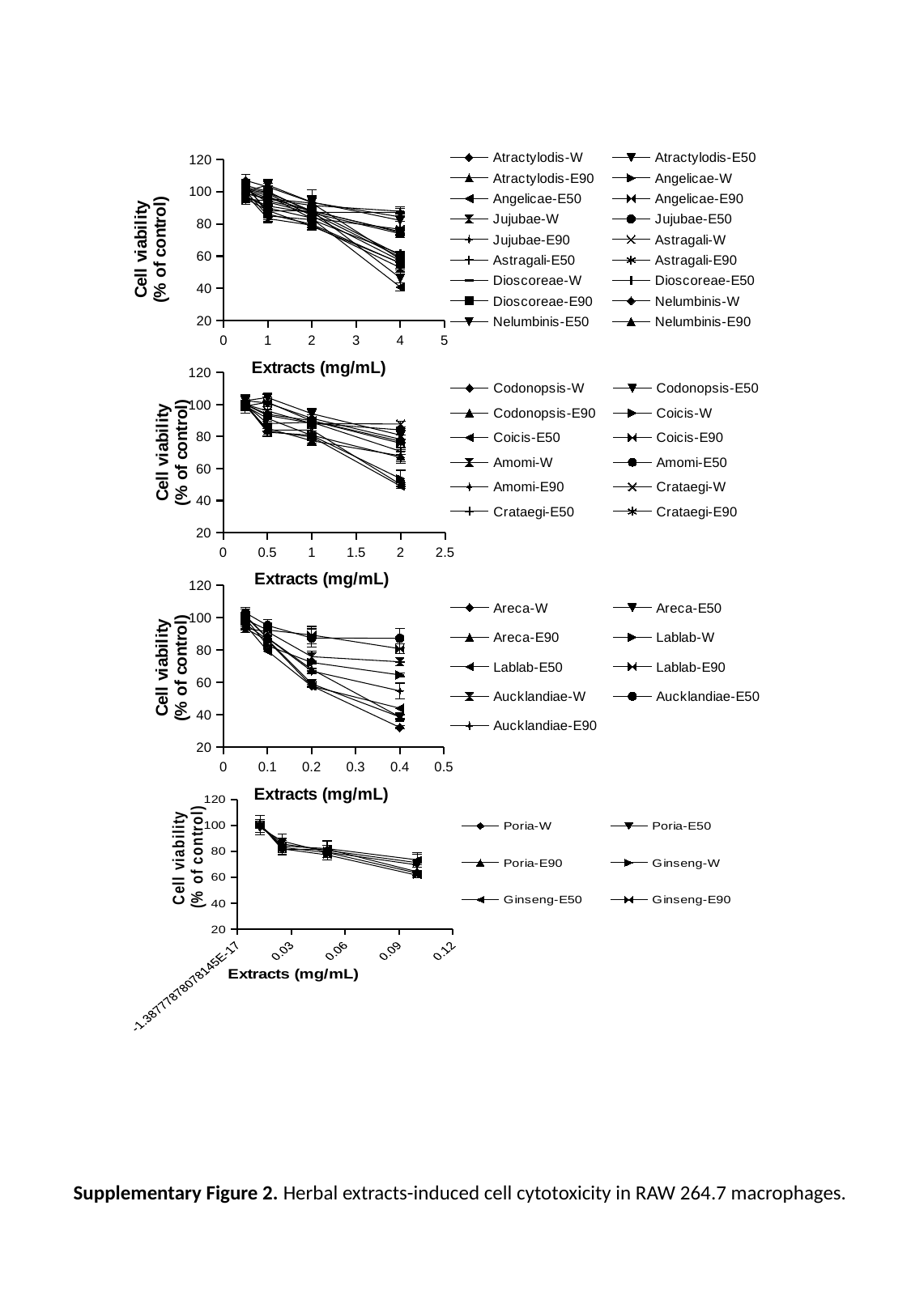
In the third chart (Areca/Lablab/Aucklandiae), do the cell viability values rise or fall along the x axis? fall In the top chart, do the cell viability values rise or fall as the extract concentration increases? fall What is the y-axis label of the bottom chart (Poria/Ginseng)? Cell viability (% of control) How many series does the legend of the bottom chart (Poria/Ginseng) list? 6 How many series does the legend of the top chart list? 18 How many series does the legend of the second chart (Codonopsis/Coicis/Amomi/Crataegi) list? 12 In the third chart (Areca/Lablab/Aucklandiae), is the lowest cell viability value at 0.4 mg/mL greater or less than 40? less What kind of chart is the top chart (Atractylodis/Angelicae/Jujubae legend)? line chart What is the x-axis label of the second chart (Codonopsis/Coicis/Amomi/Crataegi)? Extracts (mg/mL) In the top chart, is the lowest cell viability value at 4 mg/mL greater or less than 60? less How many charts are shown on the slide? 4